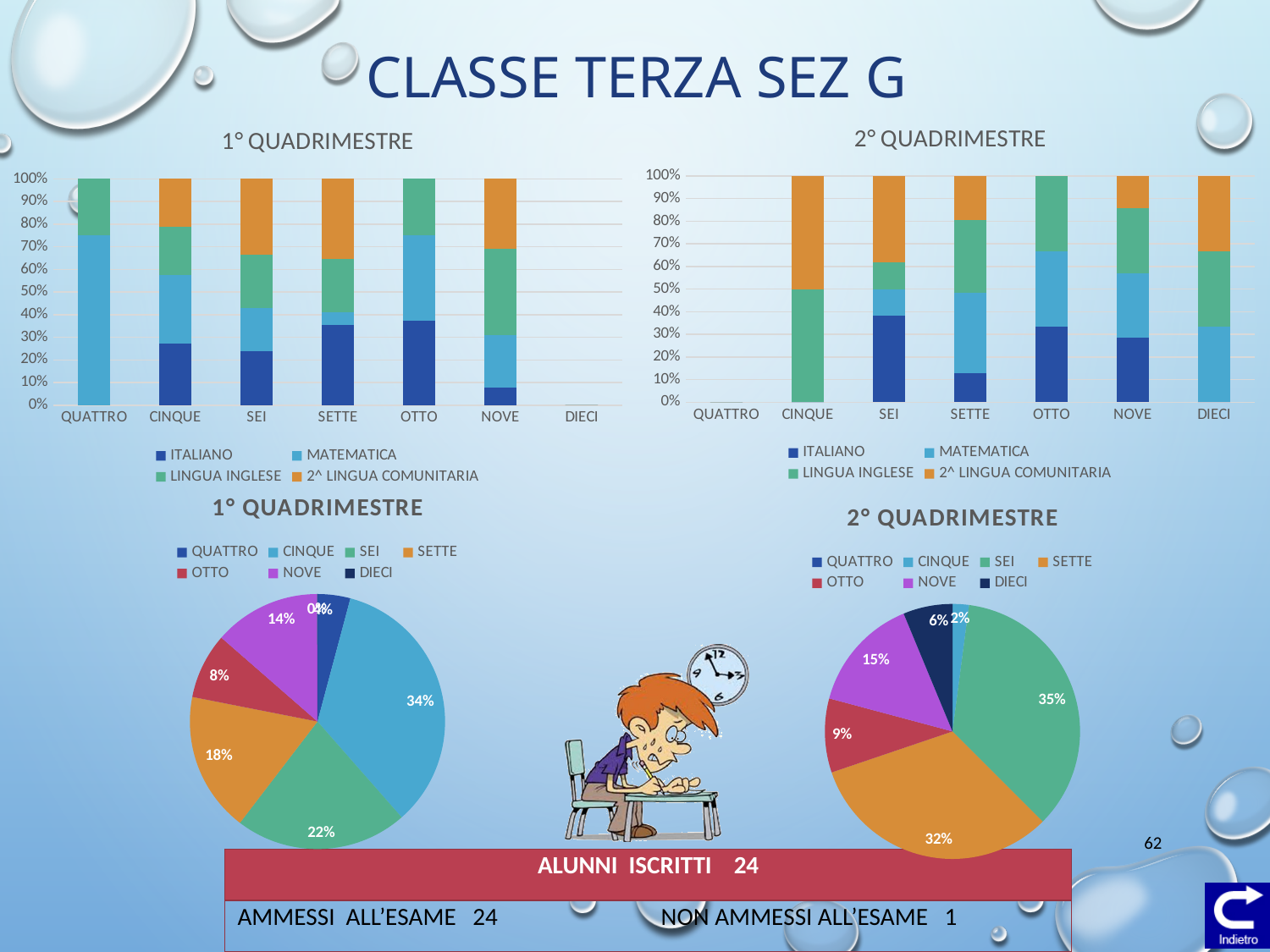
In the bottom-right 2° QUADRIMESTRE pie chart, what is the difference between the SEI and SETTE shares? 3% How many series does the legend of the top-right 2° QUADRIMESTRE bar chart list? 4 In the bottom-left 1° QUADRIMESTRE pie chart, which category has the largest slice? CINQUE In the bottom-right 2° QUADRIMESTRE pie chart, what share does NOVE have? 15% What kind of chart is the top-left chart titled 1° QUADRIMESTRE? bar chart In the bottom-left 1° QUADRIMESTRE pie chart, what share does CINQUE have? 34% How many categories are shown on the x axis of the top-left 1° QUADRIMESTRE bar chart? 7 In the bottom-left 1° QUADRIMESTRE pie chart, what share does SEI have? 22% In the top-left 1° QUADRIMESTRE bar chart, is the ITALIANO segment for OTTO greater or less than 30%? greater In the bottom-left 1° QUADRIMESTRE pie chart, which slice is larger, SETTE or OTTO? SETTE In the top-right 2° QUADRIMESTRE bar chart, is the ITALIANO segment for SETTE greater or less than 20%? less